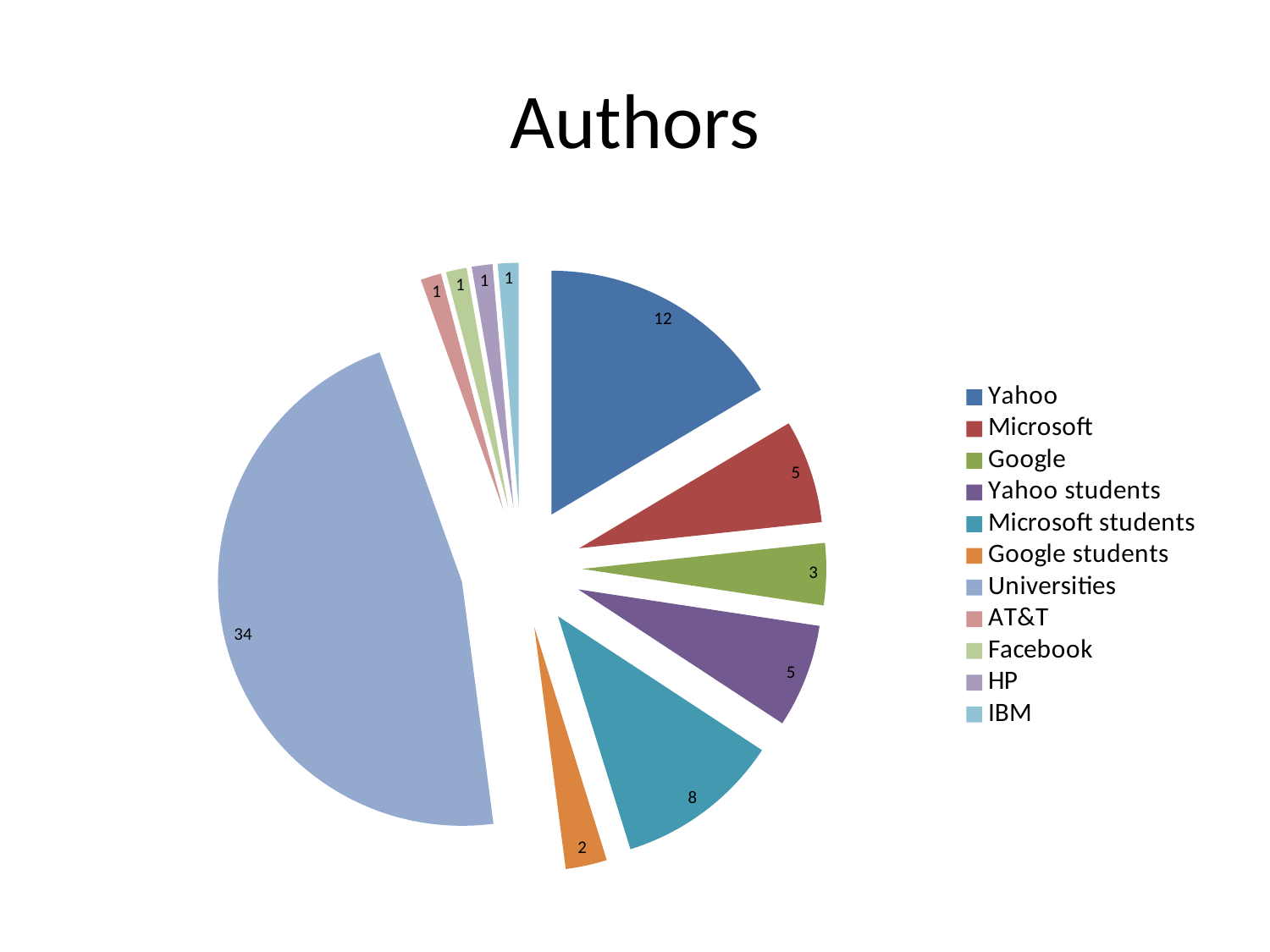
What is the value for Universities? 34 Which is larger, the value for Microsoft students or the value for Google? Microsoft students What is the total of all the slice values in the chart? 73 What is the value for Microsoft students? 8 Which category has the largest slice? Universities What is the difference between the values for Yahoo and Microsoft? 7 What is the difference between the values for Universities and Yahoo? 22 What is the value for Google students? 2 What type of chart is shown on the slide? Pie chart What is the value for Yahoo? 12 What is the title of the chart? Authors How many categories does the legend list? 11